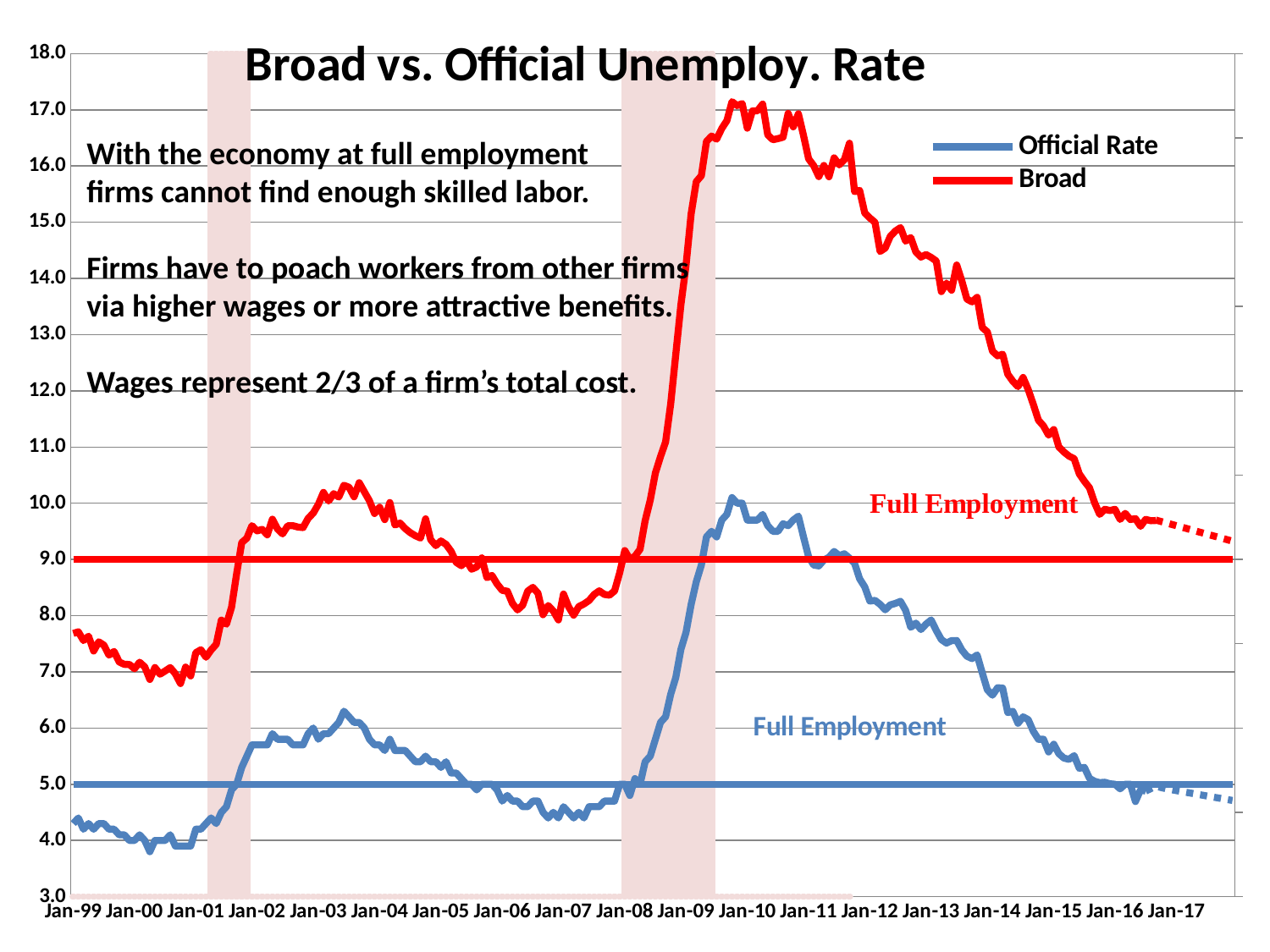
What is the title of the chart? Broad vs. Official Unemploy. Rate At what level is the red Full Employment line for the Broad rate drawn? 9.0 What kind of chart is shown on the slide? line chart Does the Broad rate rise or fall between Jan-10 and Jan-17? fall Is the Broad rate around Jan-10 greater or less than 16.0? greater Is the Official Rate at Jan-99 greater or less than 5.0? less How many series does the chart legend list? 2 Which series is higher throughout the chart, Broad or Official Rate? Broad Does the Official Rate rise or fall between Jan-08 and Jan-10? rise Which series is drawn in red according to the legend? Broad At what level is the blue Full Employment line for the Official Rate drawn? 5.0